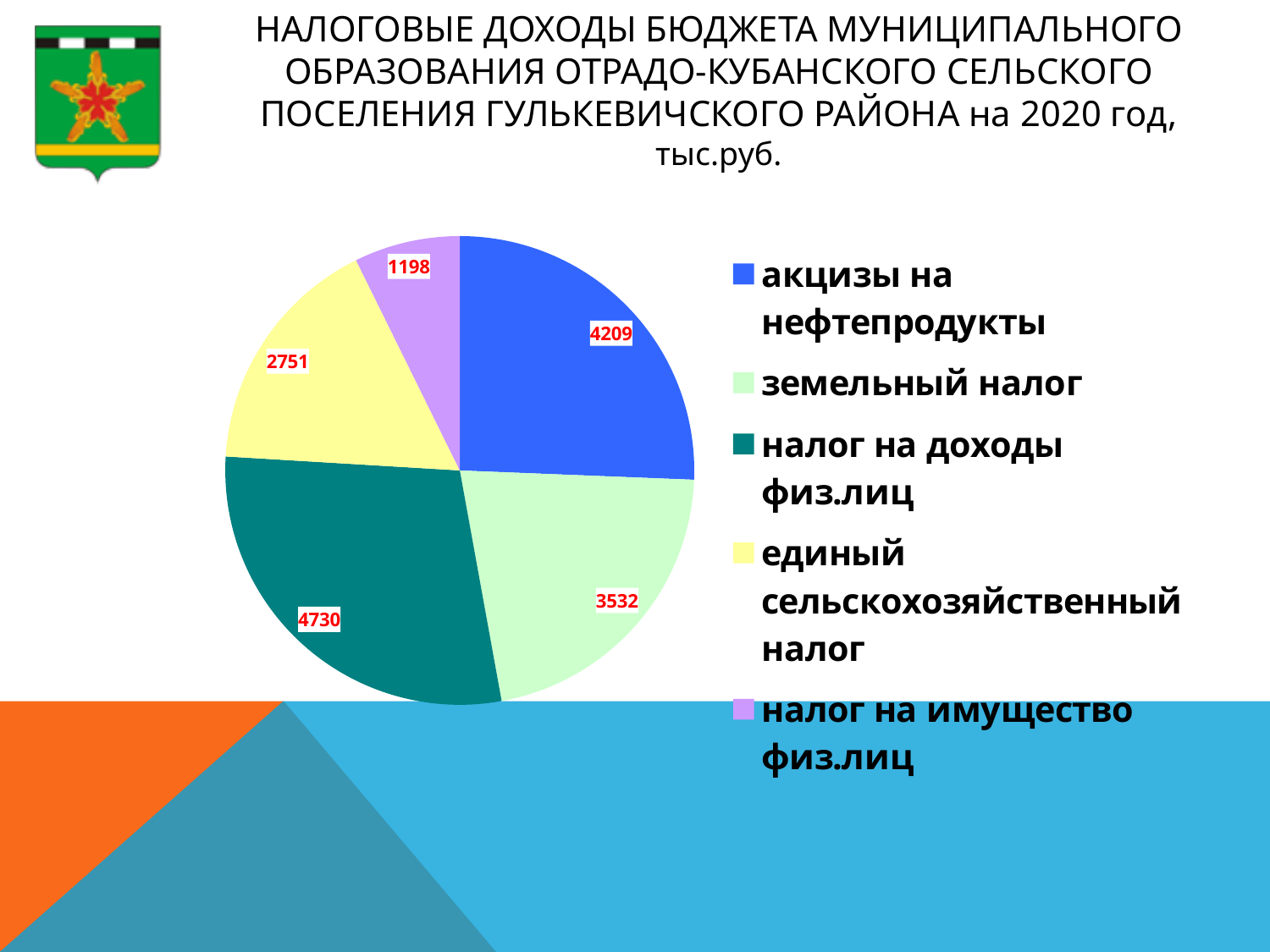
What value is shown for единый сельскохозяйственный налог? 2751 Which category has the largest slice of the pie? налог на доходы физ.лиц What kind of chart is shown on the slide? pie chart Which is larger, акцизы на нефтепродукты or земельный налог? акцизы на нефтепродукты How many categories does the pie chart have? 5 What is the difference between налог на доходы физ.лиц and земельный налог? 1198 What value is shown for акцизы на нефтепродукты? 4209 What value is shown for налог на доходы физ.лиц? 4730 What colour is the slice for единый сельскохозяйственный налог? yellow What is the total of all slices in the pie chart? 16420 What value is shown for налог на имущество физ.лиц? 1198 Which category has the smallest slice of the pie? налог на имущество физ.лиц